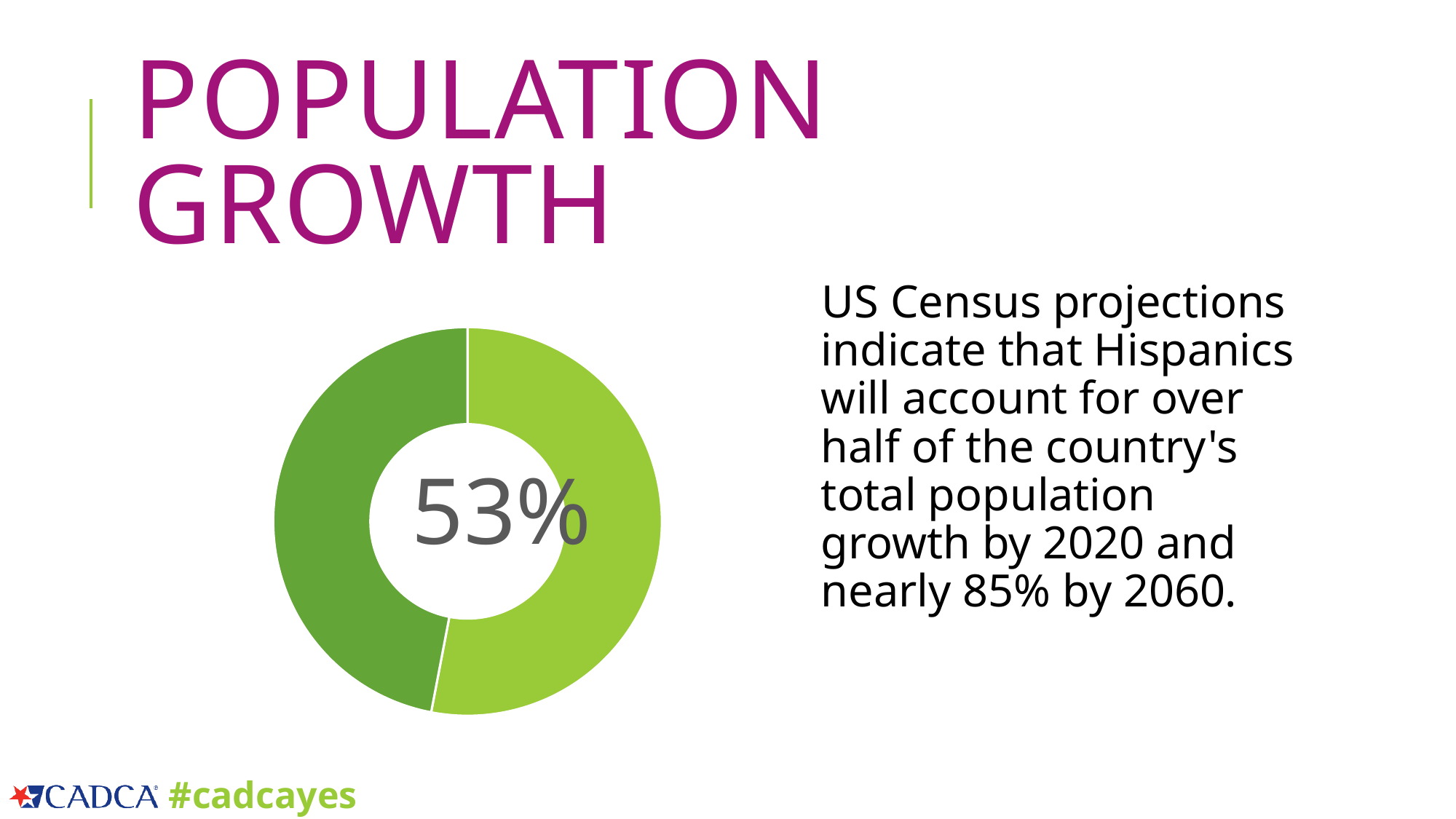
What share of the doughnut chart does the light green slice represent? 53% Which slice of the doughnut chart is larger, the light green one or the dark green one? Light green What two colours are used for the slices of the doughnut chart? Light green and dark green Is the share of the light green slice greater or less than 50%? greater What is the title of the slide containing the doughnut chart? Population Growth How many slices does the doughnut chart have? 2 What percentage is printed in the centre of the doughnut chart? 53% What kind of chart is shown on the slide? Doughnut (pie) chart